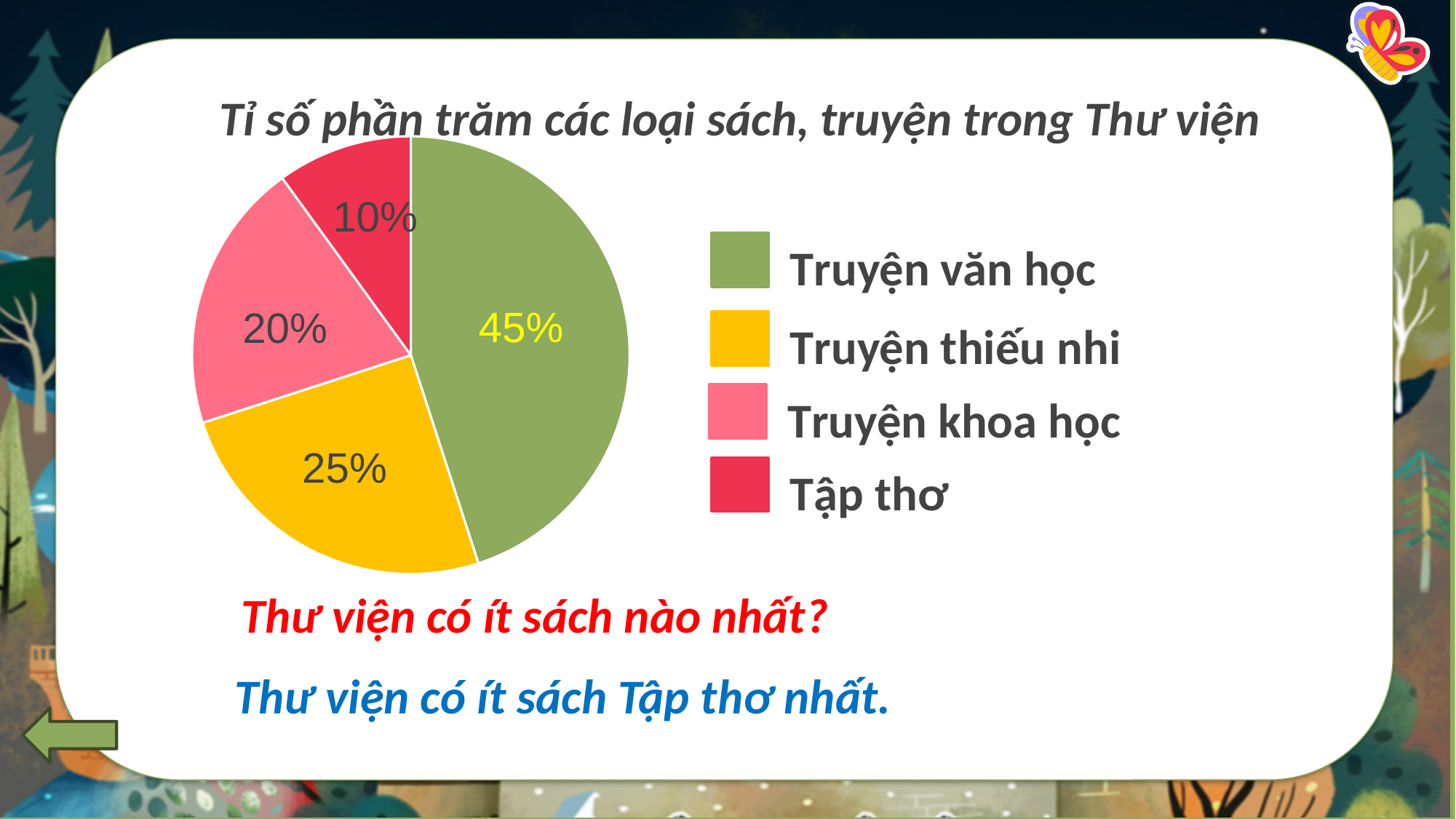
Which category has the largest share of the pie? Truyện văn học What percentage of the pie is Truyện thiếu nhi? 25% What percentage of the pie is Truyện khoa học? 20% What is the difference between the shares of Truyện văn học and Truyện thiếu nhi? 20% Which category has the smallest share of the pie? Tập thơ What is the chart's title? Tỉ số phần trăm các loại sách, truyện trong Thư viện Which is larger, the share of Truyện khoa học or the share of Tập thơ? Truyện khoa học What percentage of the pie is Tập thơ? 10% What percentage of the pie is Truyện văn học? 45% How many categories does the pie chart have? 4 What kind of chart is shown on the slide? Pie chart What colour is the slice for Truyện thiếu nhi? Yellow